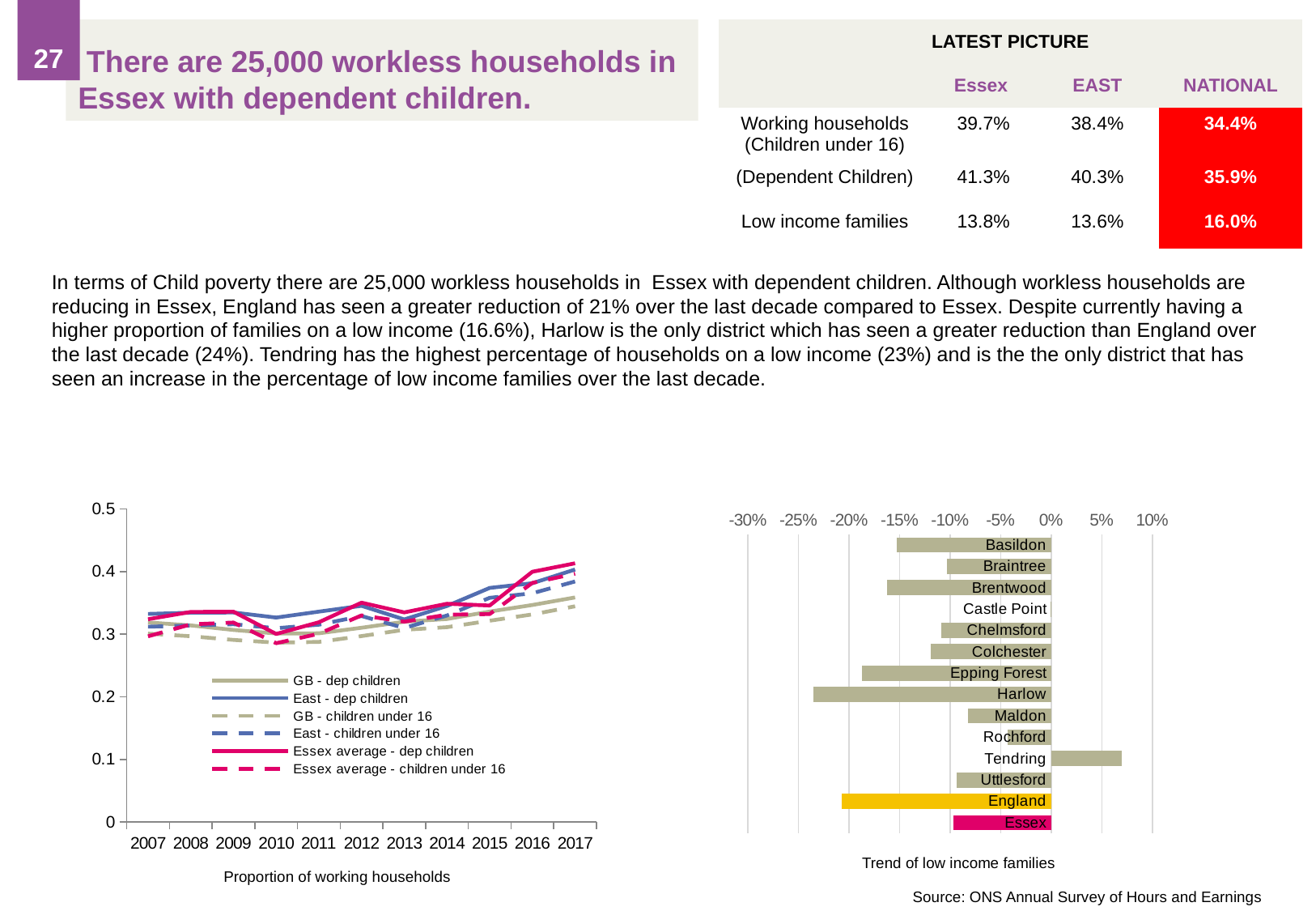
What kind of chart is the chart titled 'Proportion of working households'? line chart In the 'Proportion of working households' chart, do the values for 'Essex average - dep children' generally rise or fall from 2010 to 2017? rise In the 'Trend of low income families' chart, which category has the lowest (most negative) value? Harlow In the 'Trend of low income families' chart, is the value for Tendring greater or less than 5%? greater In the 'Proportion of working households' chart, is the value for 'East - dep children' in 2007 greater or less than 0.4? less What kind of chart is the chart titled 'Trend of low income families'? bar chart In the 'Proportion of working households' chart, is the value for 'Essex average - dep children' in 2017 greater or less than 0.3? greater How many series does the legend of the 'Proportion of working households' chart list? 6 How many years are shown on the x axis of the 'Proportion of working households' chart? 11 How many categories are shown in the 'Trend of low income families' chart? 14 In the 'Trend of low income families' chart, which category is the only one with a positive value? Tendring